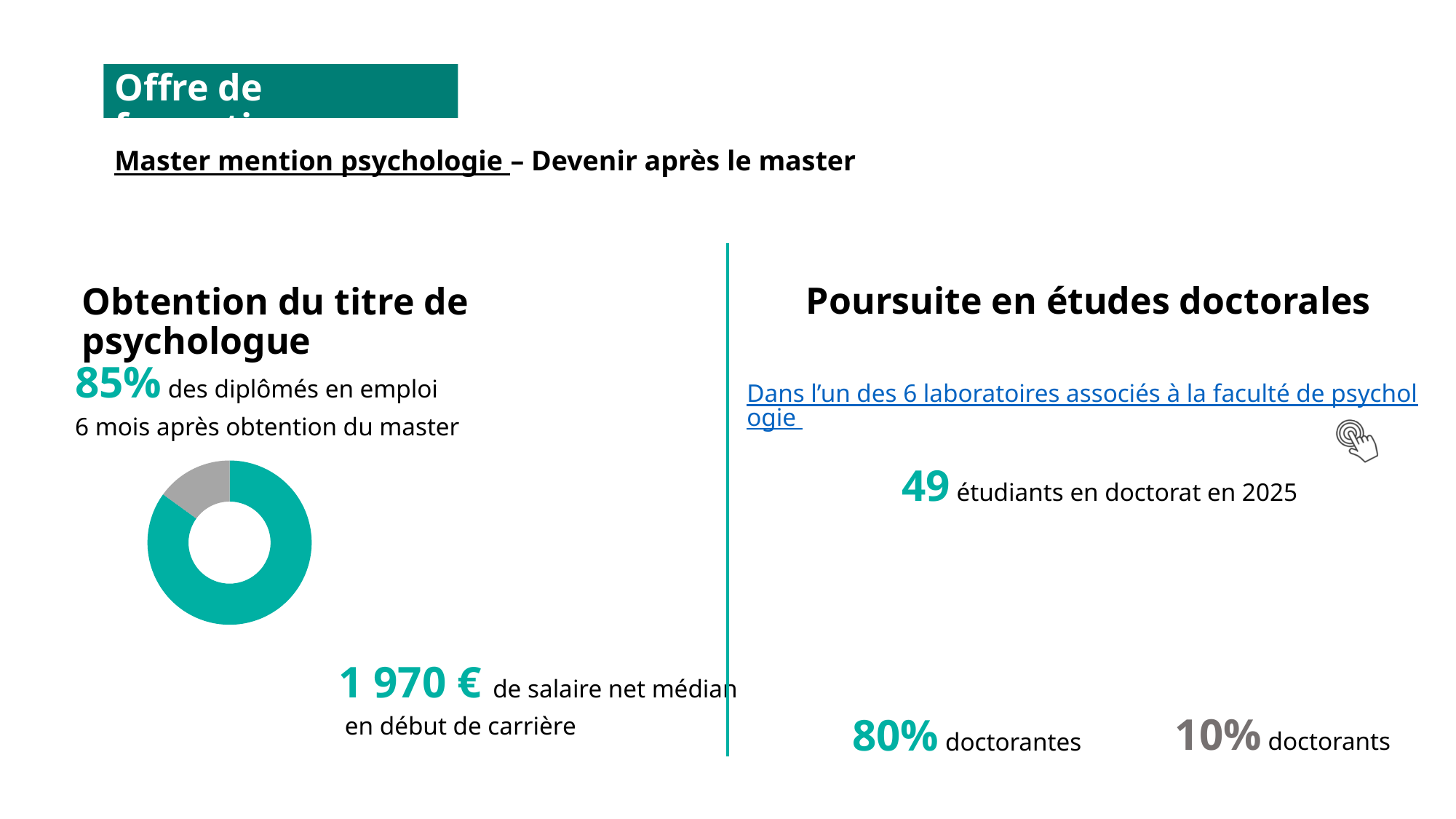
What kind of chart is shown on the left side of the slide, under the heading 'Obtention du titre de psychologue'? donut (pie) chart Which colour occupies the largest share of the donut chart on the left of the slide? teal According to the percentage printed just above the donut chart on the left, what share of graduates in employment does the large teal slice represent? 85% Does the donut chart on the left of the slide have data labels printed on its slices? No How many slices does the donut chart on the left of the slide have? 2 Which colour occupies the smallest share of the donut chart on the left of the slide? grey Does the donut chart on the left of the slide display a legend? No Is the teal slice of the donut chart on the left greater or less than half of the chart? greater In the donut chart on the left of the slide, which slice is larger, the teal one or the grey one? the teal one